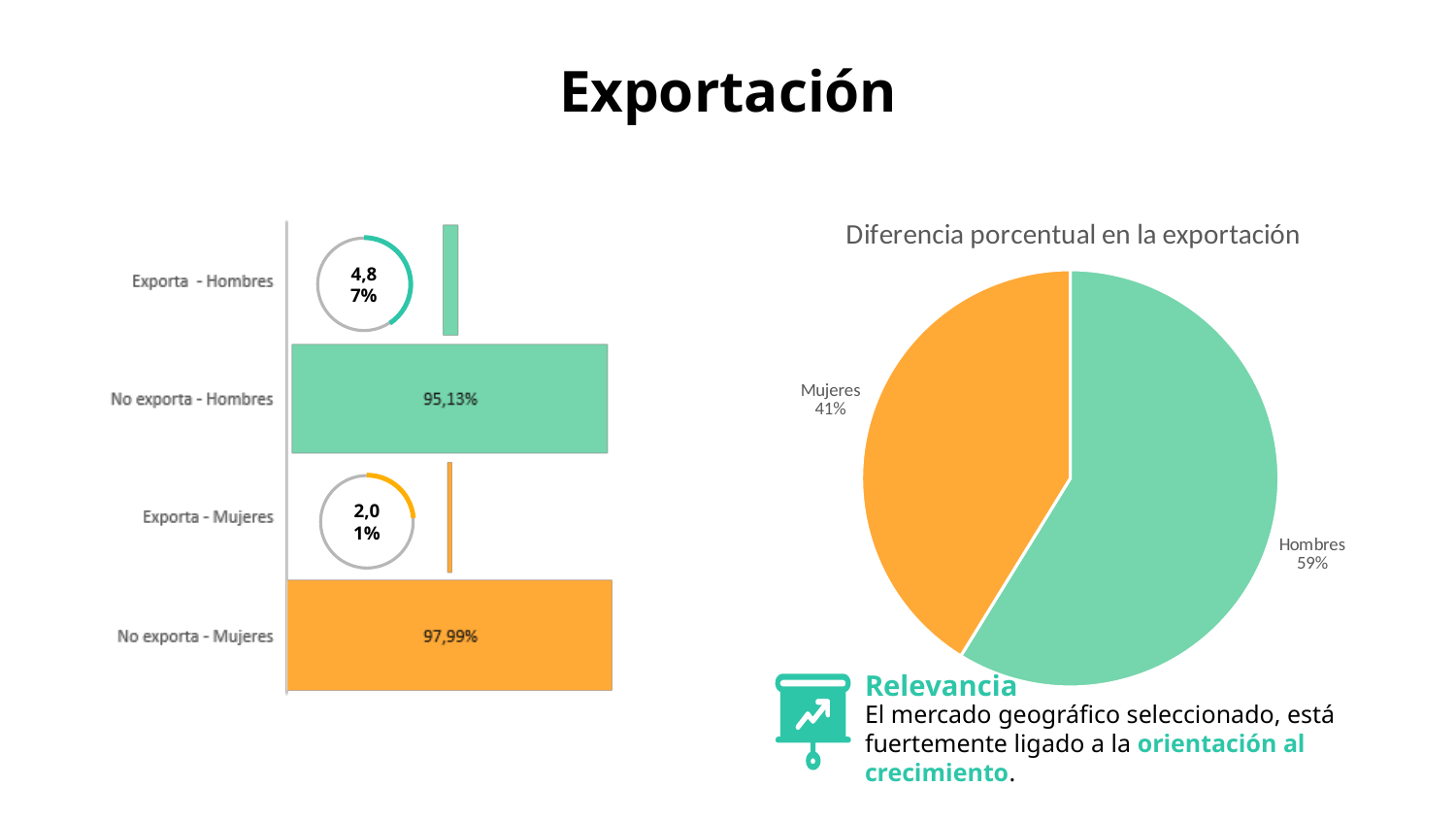
How many categories does the bar chart on the left show? 4 In the pie chart titled 'Diferencia porcentual en la exportación', which slice is larger? Hombres In the bar chart on the left, what is the value for No exporta - Hombres? 95,13% In the pie chart titled 'Diferencia porcentual en la exportación', what share does Mujeres have? 41% In the bar chart on the left, which category has the lowest value? Exporta - Mujeres In the bar chart on the left, which category has the highest value? No exporta - Mujeres In the bar chart on the left, what is the difference between No exporta - Mujeres and No exporta - Hombres? 2,86% In the bar chart on the left, what is the value for No exporta - Mujeres? 97,99% What kind of chart is shown on the left of the slide? Bar chart In the bar chart on the left, which is larger: Exporta - Hombres or Exporta - Mujeres? Exporta - Hombres In the pie chart titled 'Diferencia porcentual en la exportación', what share does Hombres have? 59% What is the title of the pie chart on the right? Diferencia porcentual en la exportación